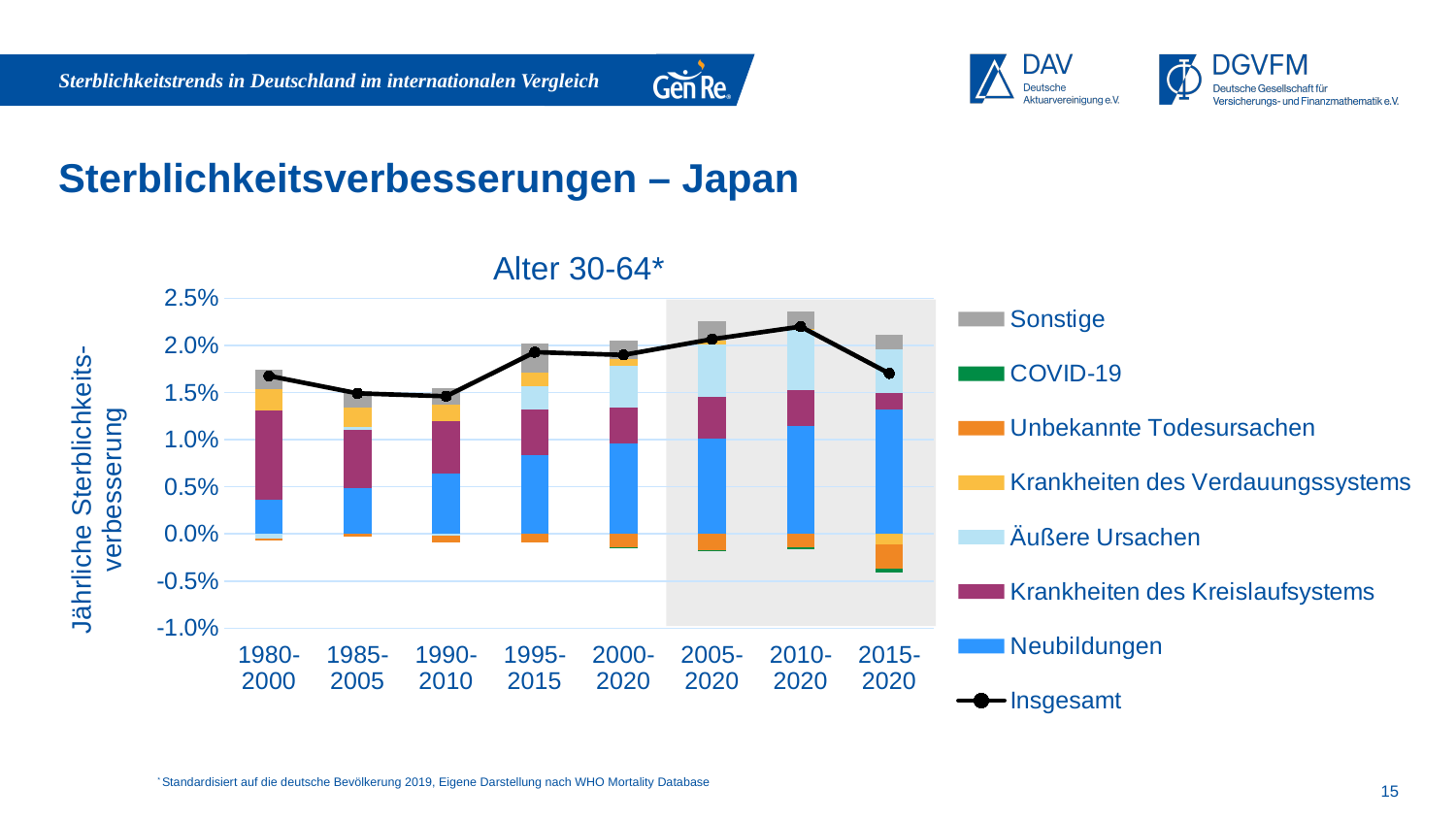
Does the Neubildungen segment generally rise or fall from 1980-2000 to 2015-2020? rise What is the title shown above the chart? Alter 30-64* Is the Neubildungen segment for 1980-2000 greater or less than 0.5%? less Which is larger, the Insgesamt value for 2010-2020 or for 2015-2020? 2010-2020 How many entries does the chart legend list? 8 Is the Insgesamt value for 2010-2020 greater or less than 2.0%? greater In which period does the Insgesamt line reach its highest value? 2010-2020 What kind of chart is shown on the slide? Stacked bar chart with a line How many time periods are shown on the x axis of the chart? 8 Which legend entry is plotted as a line with markers rather than as stacked bars? Insgesamt Is the Neubildungen segment for 2015-2020 greater or less than 1.0%? greater